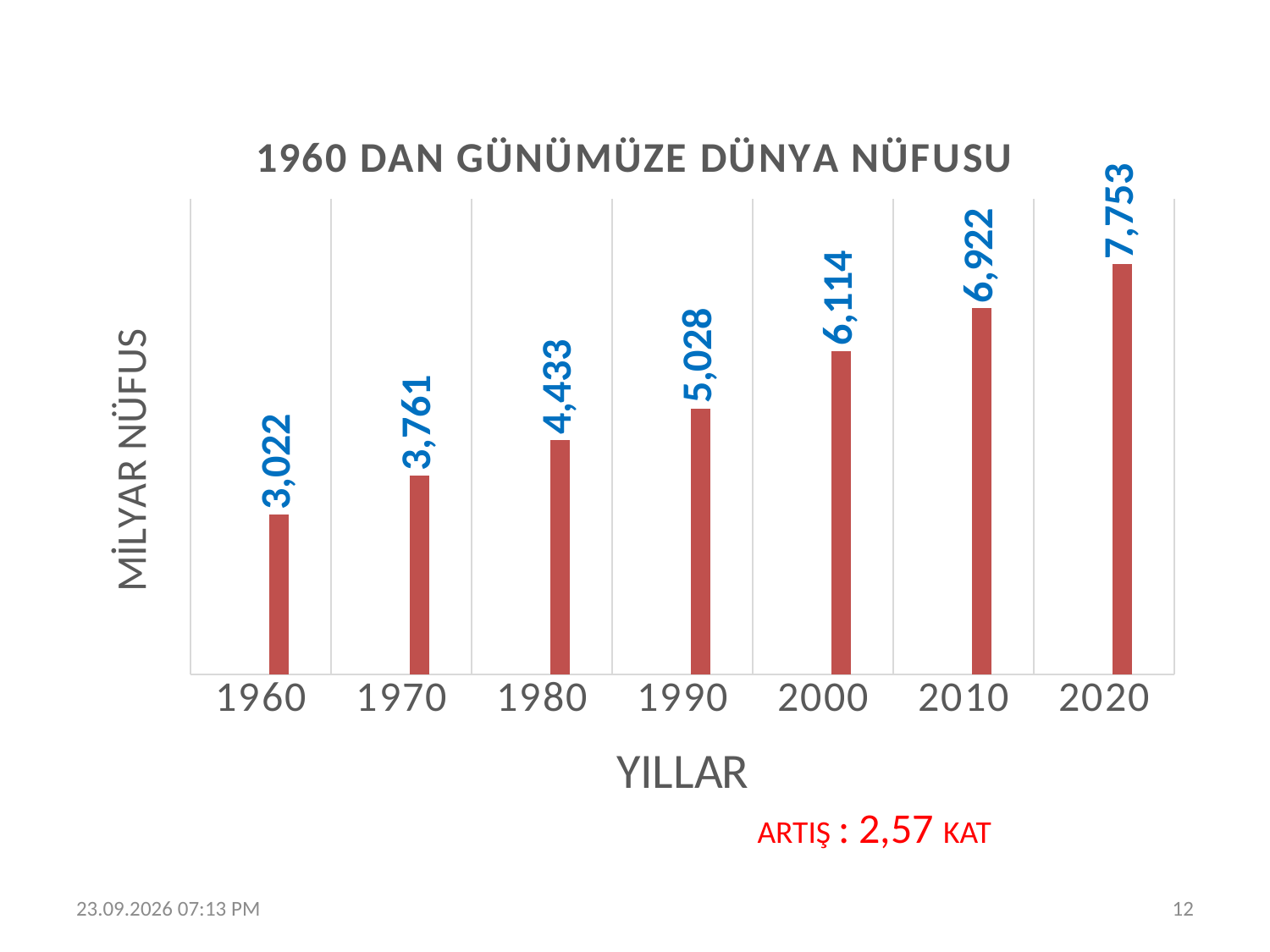
What kind of chart is this? bar chart What is the difference between the values for 2020 and 1960? 4,731 Which year has the lowest value? 1960 Do the values rise or fall from 1960 to 2020? rise What is the value shown for 2000? 6,114 How many years are shown on the x axis? 7 Which is larger, the value for 1980 or the value for 1970? 1980 What is the difference between the values for 2010 and 2000? 0,808 What is the value shown for 2020? 7,753 What is the world population value shown for 1960? 3,022 Which year has the highest value? 2020 What is the value shown for 1990? 5,028